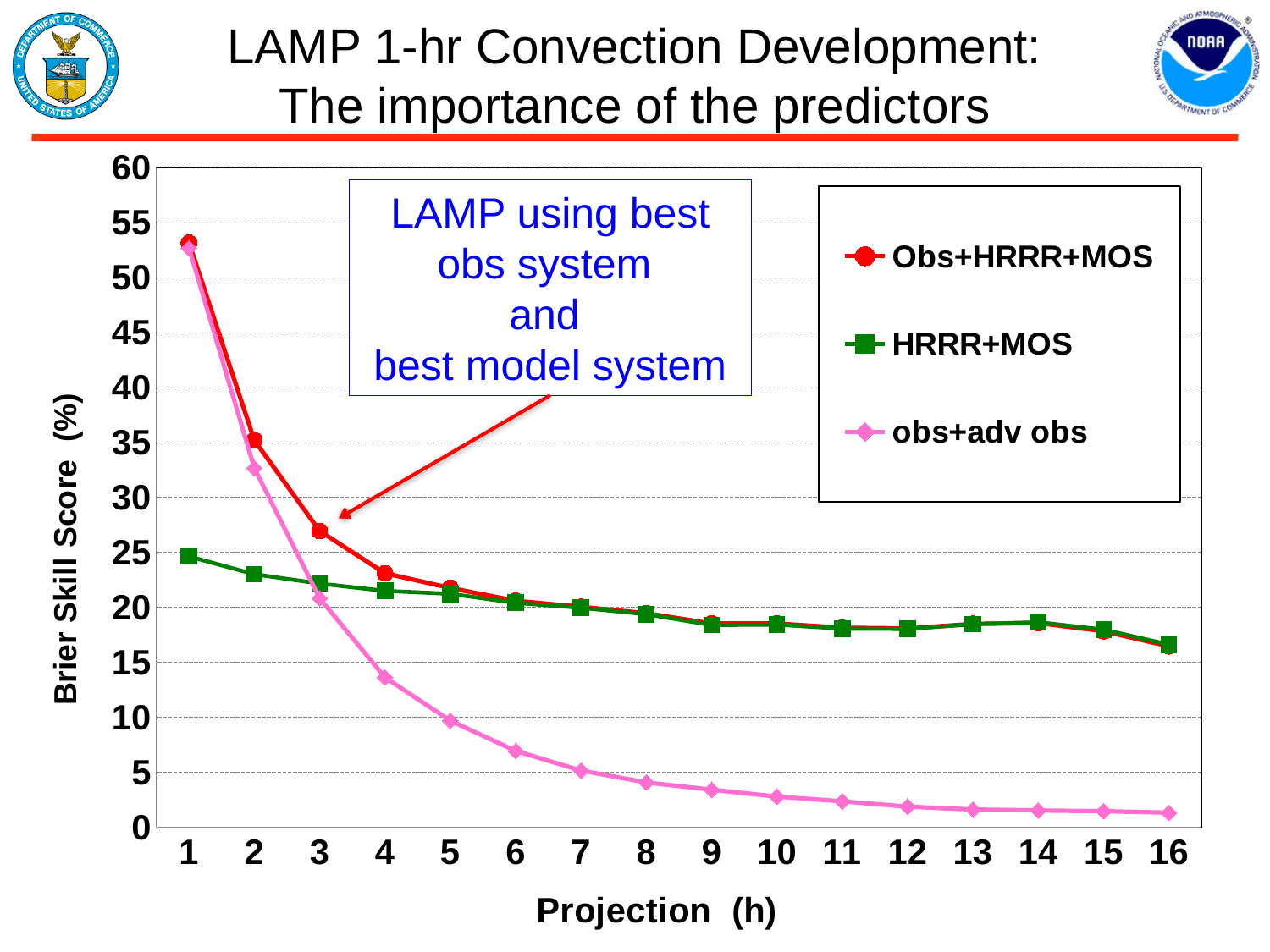
What is the label of the y axis? Brier Skill Score (%) Does the Brier Skill Score for obs+adv obs rise or fall as the projection hour increases? fall Is the Brier Skill Score for Obs+HRRR+MOS at projection 1 greater or less than 50? greater Which series has the lowest Brier Skill Score at projection 16? obs+adv obs At projection 8, which series has the higher Brier Skill Score, HRRR+MOS or obs+adv obs? HRRR+MOS What kind of chart is shown on the slide? line chart How many series does the legend list? 3 Is the Brier Skill Score for HRRR+MOS at projection 1 greater or less than 30? less At projection 1, which series has the higher Brier Skill Score, Obs+HRRR+MOS or HRRR+MOS? Obs+HRRR+MOS How many projection hours are plotted along the x axis? 16 At which projection hour does Obs+HRRR+MOS reach its highest Brier Skill Score? 1 Is the Brier Skill Score for obs+adv obs at projection 16 greater or less than 5? less